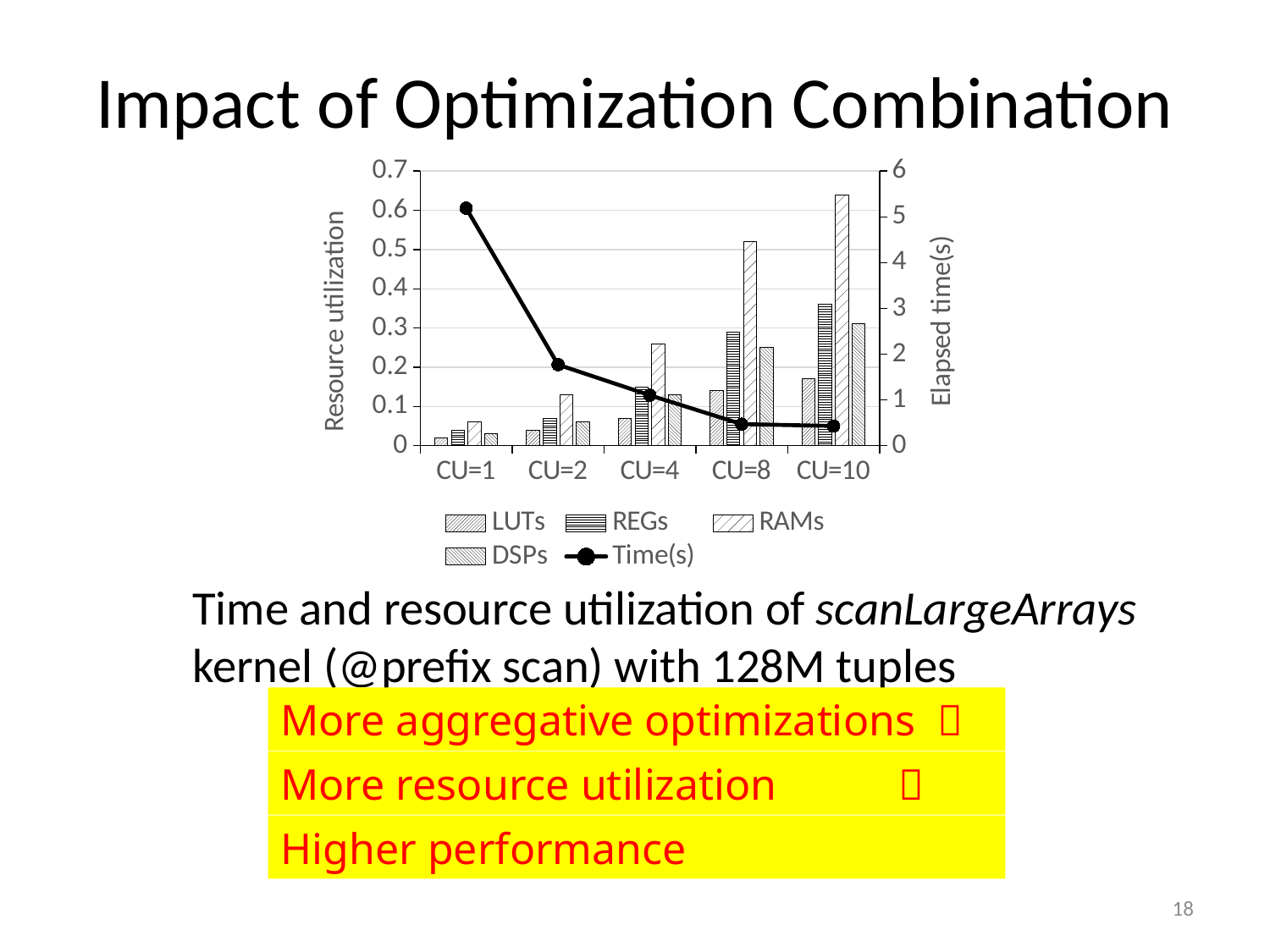
Does the Time(s) line rise or fall as CU increases along the x axis? Falls What kind of chart is shown on the slide? A bar chart combined with a line Which CU category has the highest elapsed time? CU=1 Do the RAMs bars rise or fall as CU increases along the x axis? Rise What is the title of the right-hand vertical axis? Elapsed time(s) How many CU categories are shown on the x axis? 5 How many series does the legend list? 5 Is the Time(s) value for CU=1 greater or less than 4? greater Is the Time(s) value for CU=2 greater or less than 3? less Which CU category has the highest RAMs utilization? CU=10 Is the RAMs value for CU=8 greater or less than 0.4? greater At CU=8, which is larger, the RAMs bar or the DSPs bar? RAMs